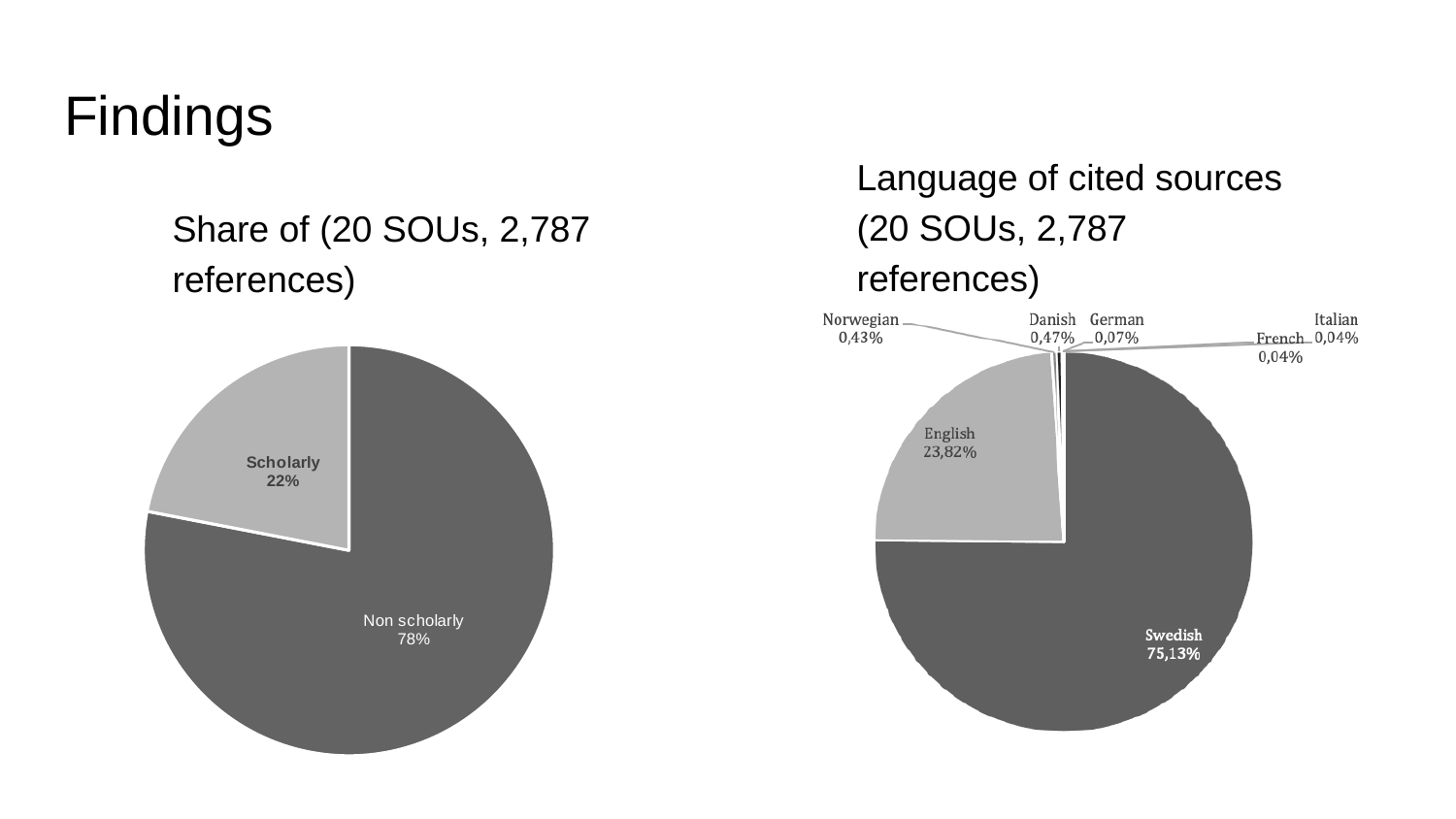
In the 'Language of cited sources' chart, which has the larger share, Danish or Norwegian? Danish In the left pie chart, what is the difference in percentage points between Non scholarly and Scholarly? 56 In the 'Language of cited sources' chart, which language has the largest share? Swedish In the 'Language of cited sources' chart, what is the share for Norwegian? 0,43% In the left pie chart, what share of references is Non scholarly? 78% In the 'Language of cited sources' chart, what is the share for English? 23,82% What kind of chart is used for 'Language of cited sources'? Pie chart In the 'Language of cited sources' chart, what is the share for Swedish? 75,13% In the 'Language of cited sources' chart, what is the share for German? 0,07% How many languages are shown in the 'Language of cited sources' chart? 7 In the left pie chart, which category has the larger share? Non scholarly In the left pie chart, what share of references is Scholarly? 22%